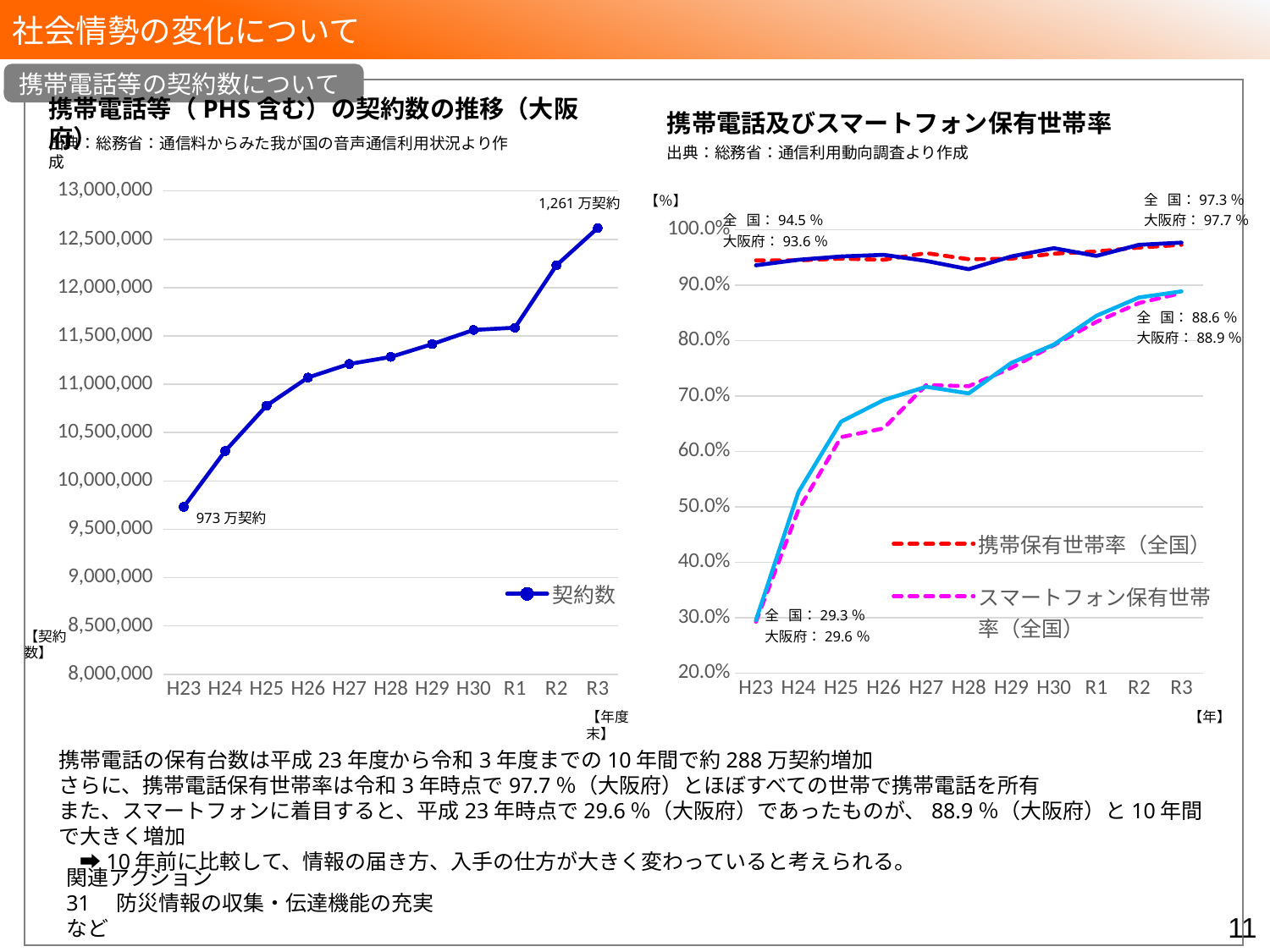
How many year categories are shown on the x axis of the left chart (契約数の推移)? 11 In the left chart (契約数の推移), is the value for R1 greater or less than 12,000,000? less In the right chart (携帯電話及びスマートフォン保有世帯率), by how many percentage points did the 大阪府 smartphone ownership rate increase from H23 (29.6%) to R3 (88.9%)? 59.3 In the right chart (携帯電話及びスマートフォン保有世帯率), at R3 which is higher for mobile phone ownership: 全国 (97.3%) or 大阪府 (97.7%)? 大阪府 In the left chart (契約数の推移), do the values rise or fall from H23 to R3? rise In the left chart (契約数の推移), what value is labelled at R3? 1,261万契約 In the left chart (契約数の推移), is the value for H25 greater or less than 11,000,000? less What series name does the legend of the left chart (契約数の推移) show? 契約数 What kind of chart is the left chart, 携帯電話等（PHS含む）の契約数の推移（大阪府）? line chart In the right chart (携帯電話及びスマートフォン保有世帯率), what is the smartphone ownership rate for 大阪府 at H23? 29.6% In the right chart (携帯電話及びスマートフォン保有世帯率), what is the smartphone ownership rate for 大阪府 at R3? 88.9% In the left chart (契約数の推移), what value is labelled at H23? 973万契約